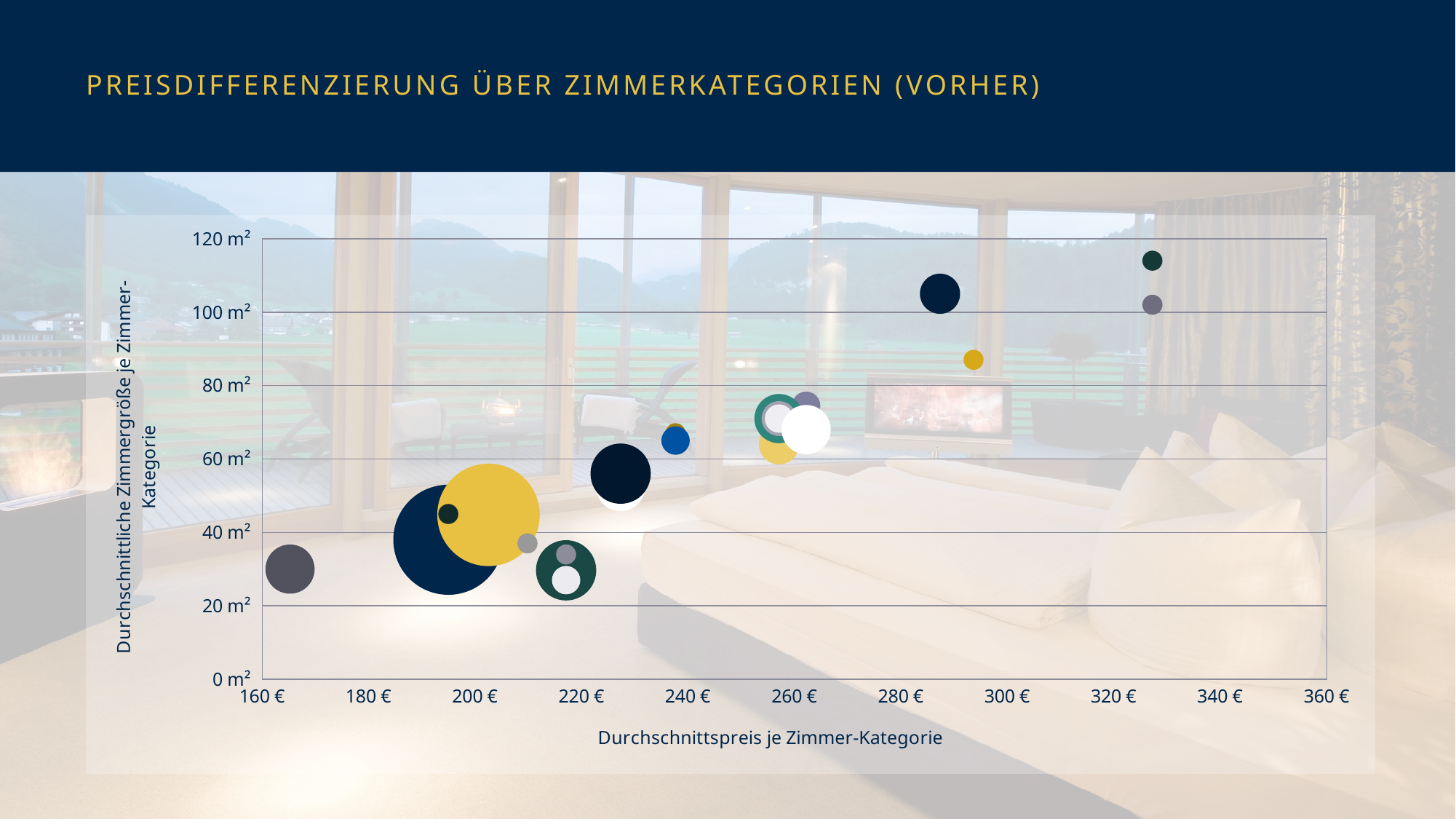
What is the lowest tick value shown on the horizontal axis of the chart? 160 € What is the label of the horizontal axis of the chart? Durchschnittspreis je Zimmer-Kategorie What is the highest tick value shown on the horizontal axis of the chart? 360 € What is the highest tick value shown on the vertical axis of the chart? 120 m² What is the title of the chart on the slide? Preisdifferenzierung über Zimmerkategorien (vorher) What kind of chart is shown on the slide? Bubble chart